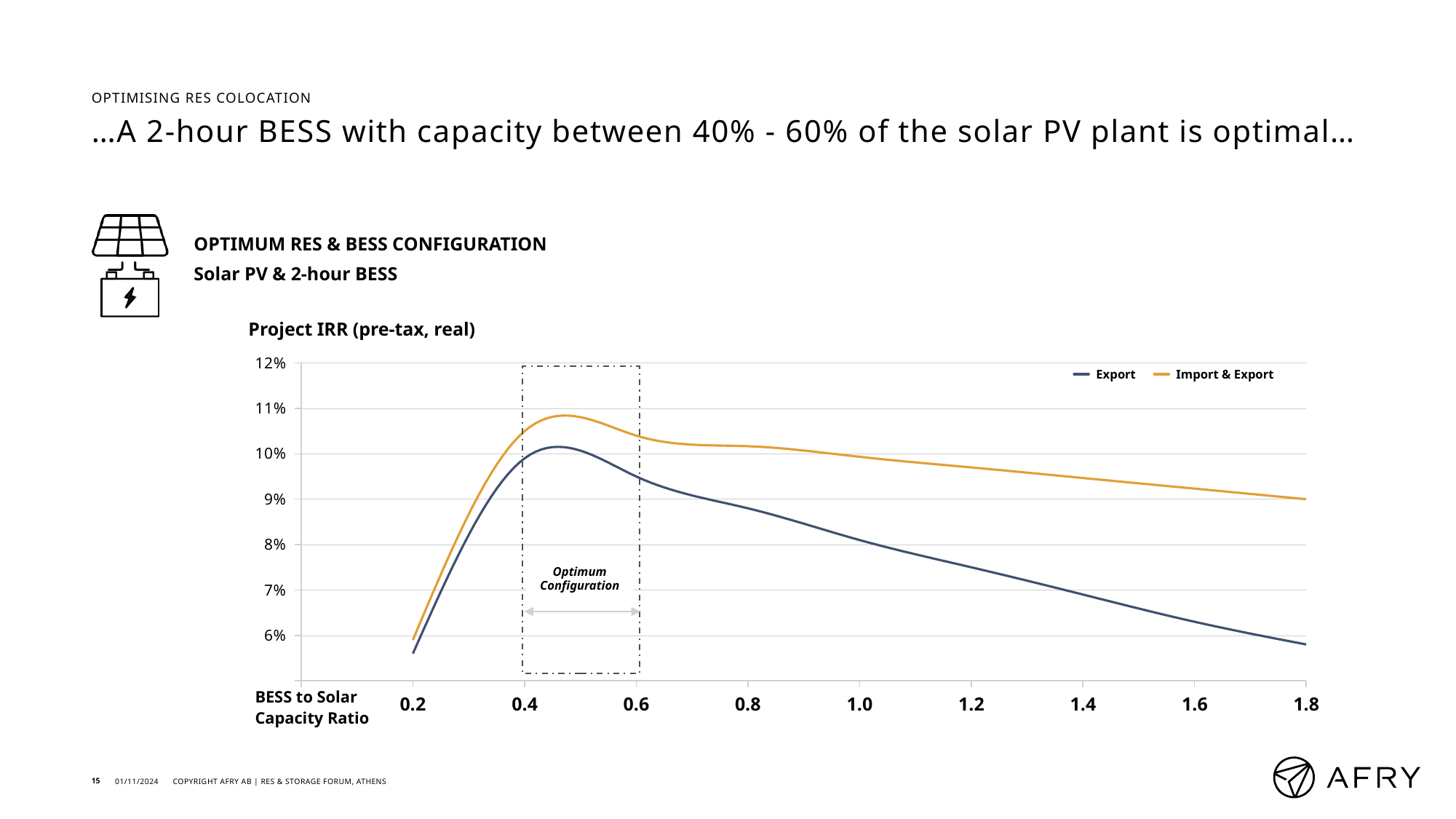
Is the peak value of the Import & Export series greater or less than 10%? greater How many series does the legend list? 2 At a BESS to Solar Capacity Ratio of 1.0, which series has the higher Project IRR, Export or Import & Export? Import & Export What is the title of the chart? Project IRR (pre-tax, real) Is the value of the Export series at a BESS to Solar Capacity Ratio of 0.2 greater or less than 6%? less Is the value of the Export series at a BESS to Solar Capacity Ratio of 1.8 greater or less than 6%? less What range of BESS to Solar Capacity Ratio is marked as the Optimum Configuration? 0.4 to 0.6 Does the Export series rise or fall as the BESS to Solar Capacity Ratio increases from 0.6 to 1.8? Fall What kind of chart is shown on the slide? Line chart